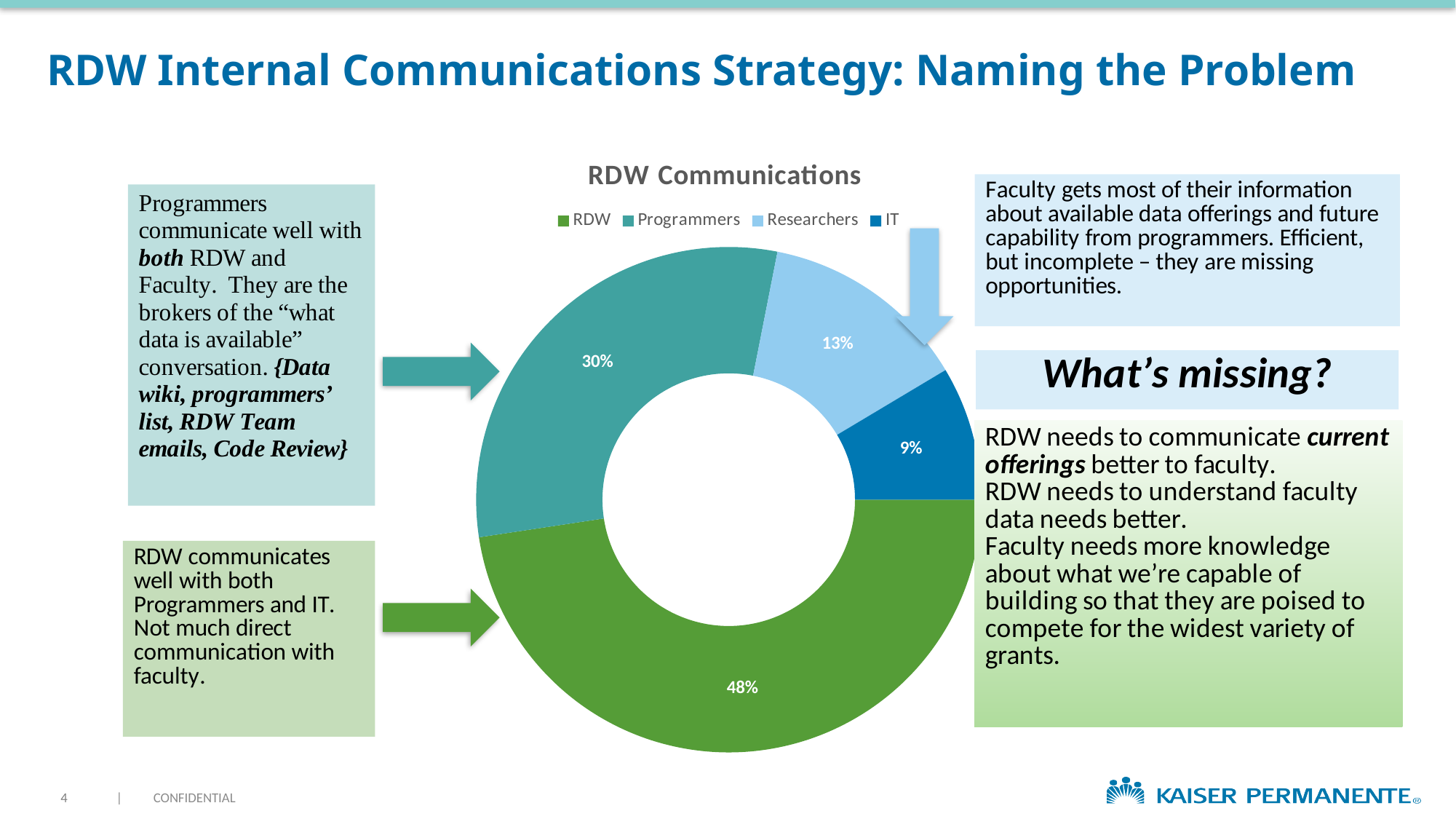
What kind of chart is shown on the slide? pie chart (doughnut) What share of the chart does RDW account for? 48% What share of the chart does Programmers account for? 30% Which category has the largest slice? RDW What share of the chart does IT account for? 9% What is the title of the chart? RDW Communications What share of the chart does Researchers account for? 13% What is the difference in percentage points between the RDW slice and the Programmers slice? 18 How many categories does the legend list? 4 Which slice is larger, Researchers or IT? Researchers What colour is the RDW slice? green Which category has the smallest slice? IT